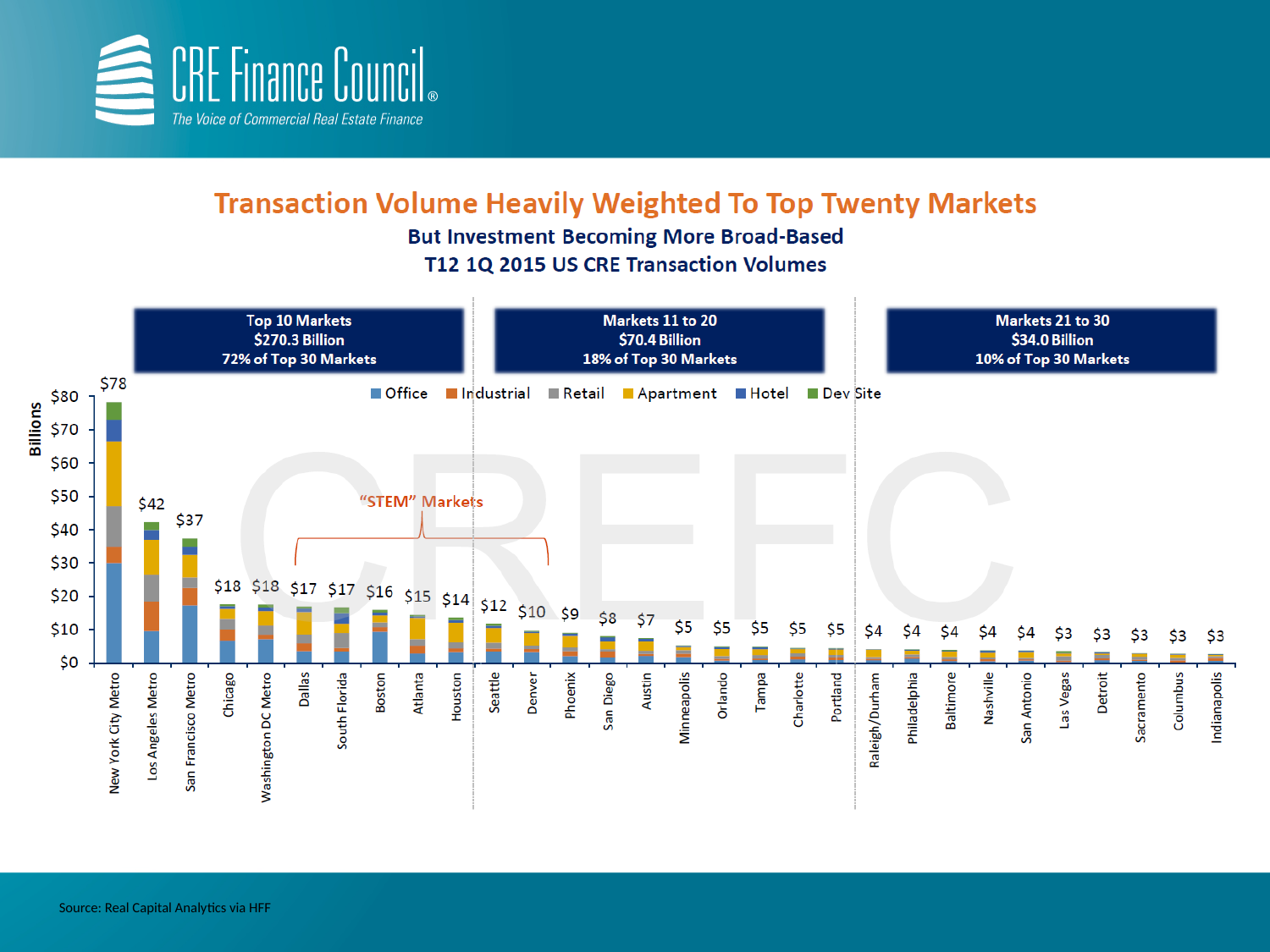
Is the Office segment for New York City Metro greater or less than $20? greater What kind of chart is shown on the slide? Stacked bar chart Which market has the highest total transaction volume? New York City Metro How many series does the chart legend list? 6 Do the total transaction volumes rise or fall moving from left to right along the x axis? Fall What is the lowest total value labeled on any bar in the chart? $3 What is the total transaction volume labeled for Seattle? $12 Which has a larger labeled total, Seattle or Denver? Seattle What is the difference between the labeled totals for New York City Metro and Los Angeles Metro? $36 How many markets are shown on the x axis of the chart? 30 What is the total transaction volume labeled for New York City Metro? $78 What is the total transaction volume labeled for Los Angeles Metro? $42